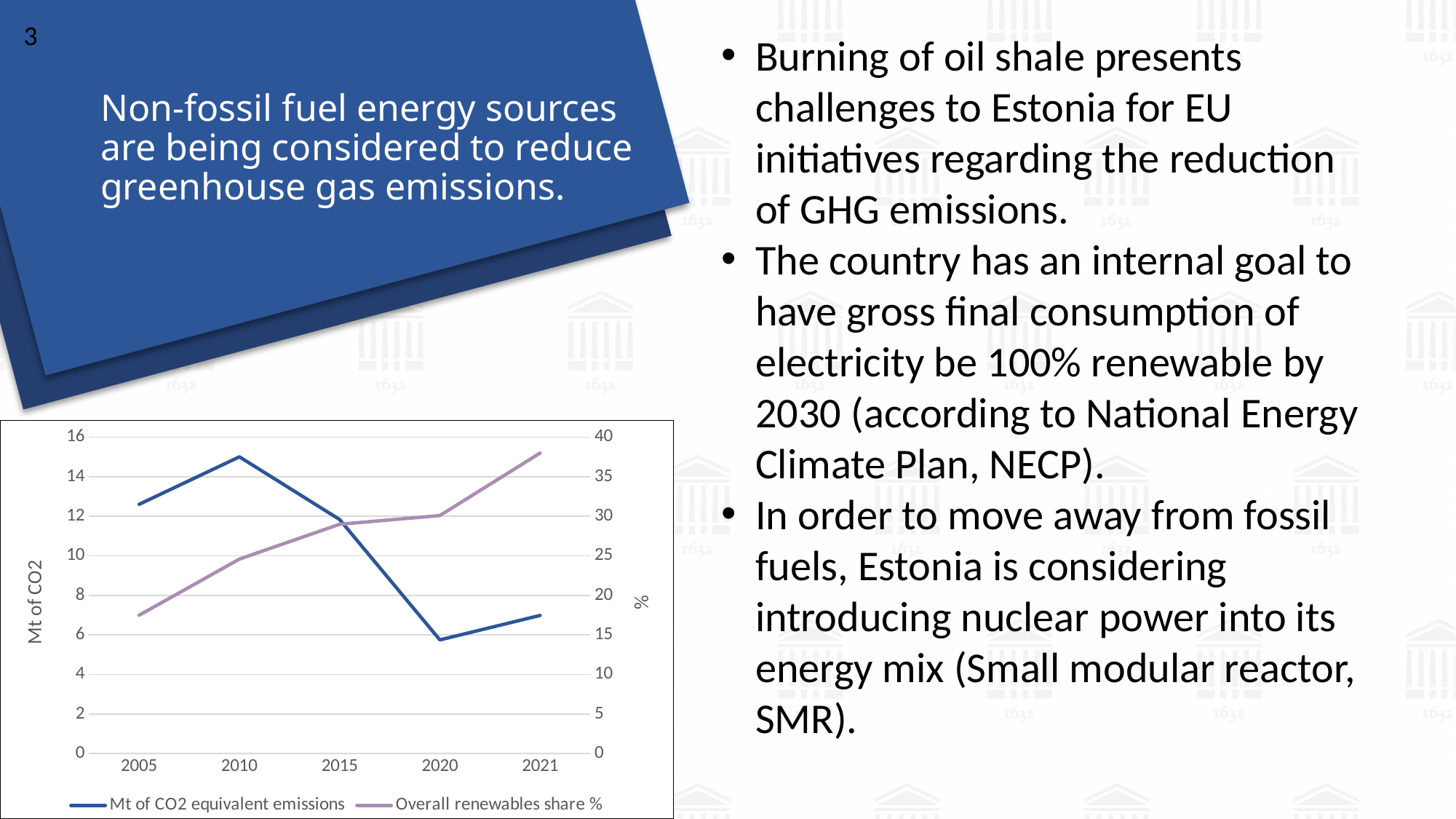
Is the value for Mt of CO2 equivalent emissions in 2020 greater or less than 8? less In which year is the Mt of CO2 equivalent emissions series at its highest? 2010 How many series does the chart legend list? 2 What kind of chart is shown on the slide? line chart Is the Overall renewables share % in 2021 greater or less than 35? greater Does the Overall renewables share % rise or fall from 2005 to 2021? rise In which year is the Mt of CO2 equivalent emissions series at its lowest? 2020 What is the label on the left vertical axis of the chart? Mt of CO2 Is the Overall renewables share % in 2005 greater or less than 20? less How many years are plotted along the x axis of the chart? 5 In which year is the Overall renewables share % at its highest? 2021